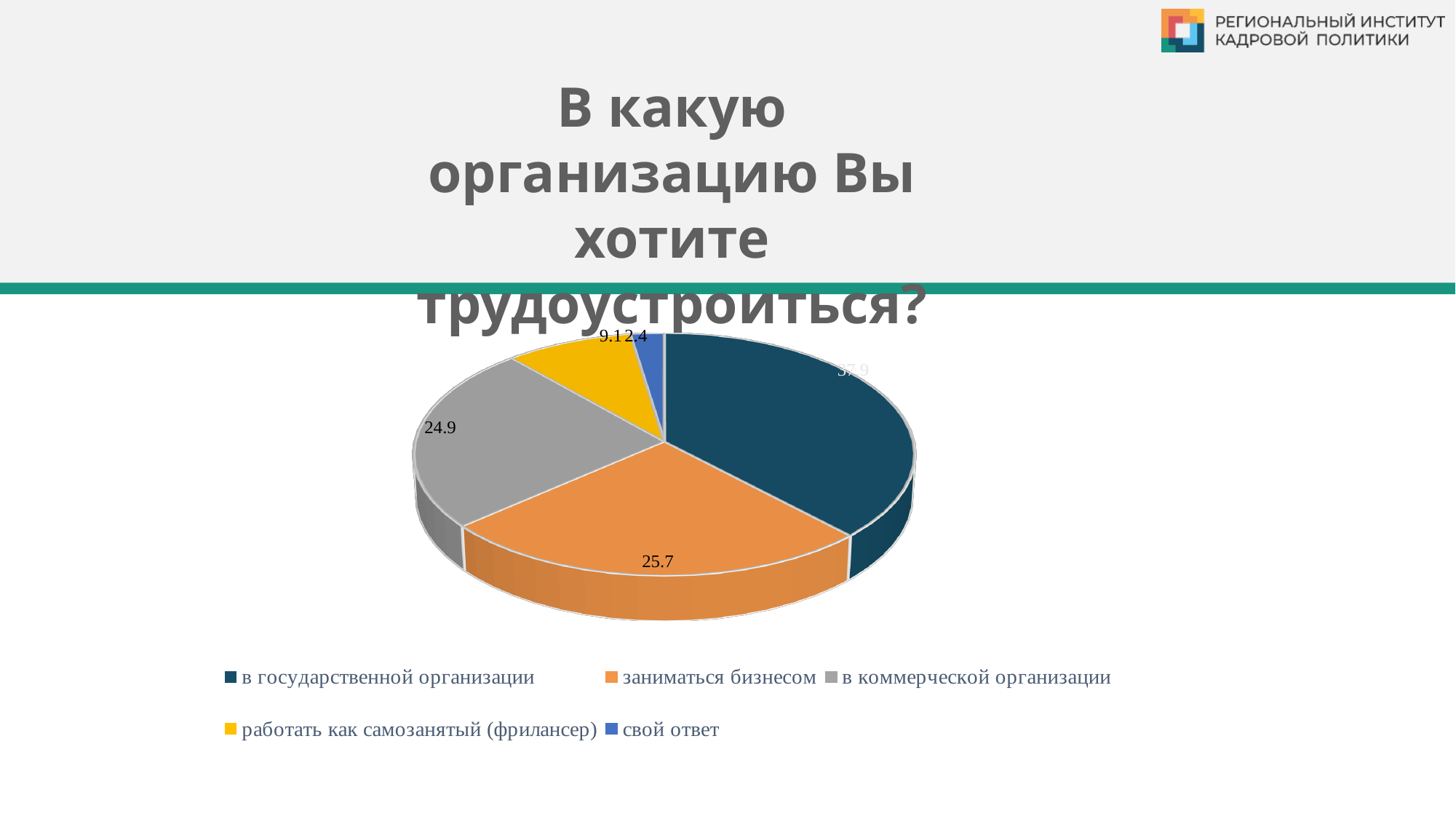
What is the value for "в государственной организации"? 37.9 Which is larger: the value for "заниматься бизнесом" or the value for "в коммерческой организации"? заниматься бизнесом Which category has the largest slice of the pie? в государственной организации What is the value for "заниматься бизнесом"? 25.7 What is the value for "работать как самозанятый (фрилансер)"? 9.1 What colour is the slice for "работать как самозанятый (фрилансер)"? yellow What is the value for "свой ответ"? 2.4 Which category has the smallest slice of the pie? свой ответ How many categories does the pie chart have? 5 What is the value for "в коммерческой организации"? 24.9 What type of chart is shown on the slide? pie chart What is the difference between the values for "в государственной организации" and "заниматься бизнесом"? 12.2